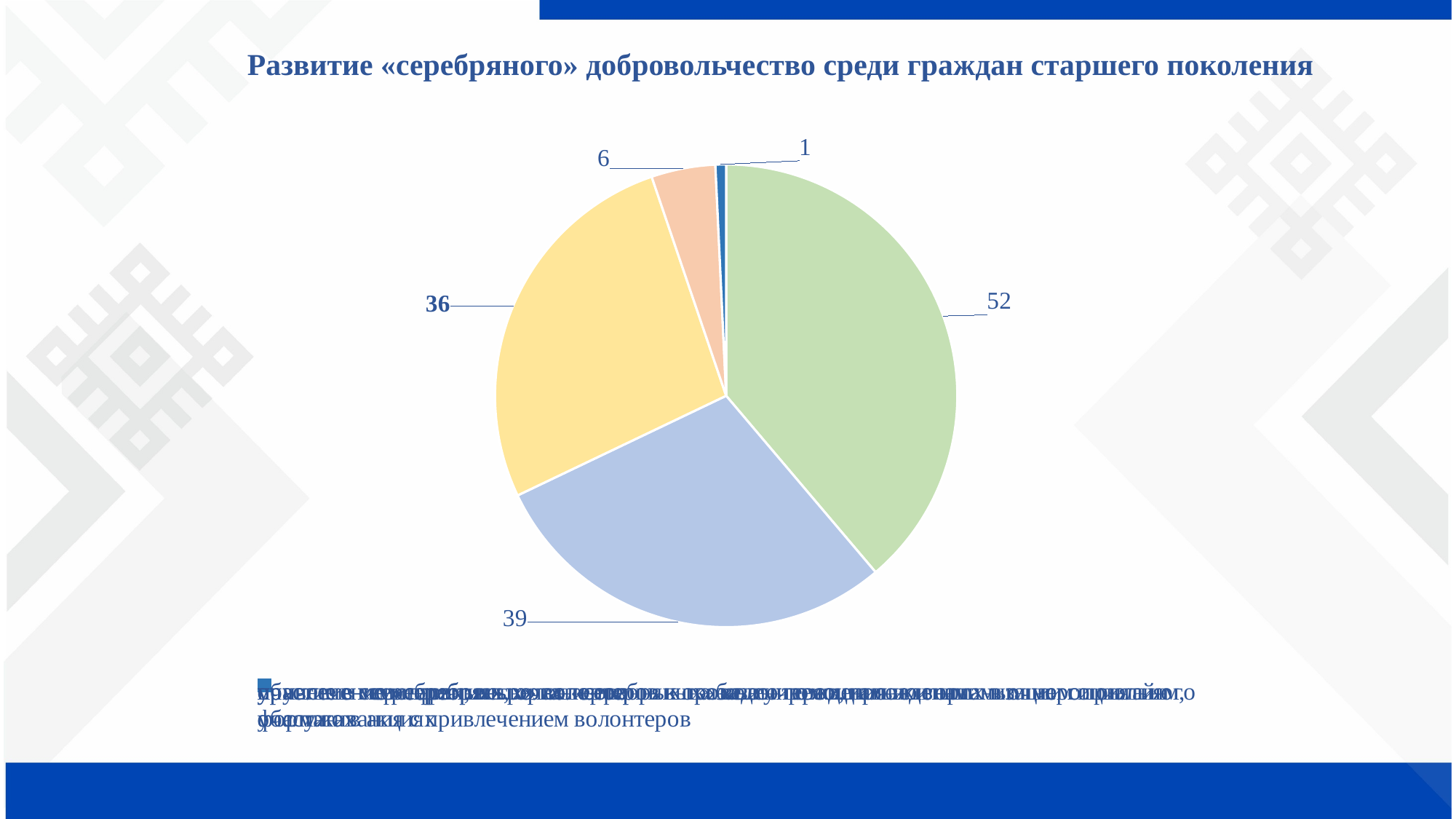
What is the sum of all the values labelled on the pie chart? 134 What is the value of the yellow slice of the pie chart? 36 How many slices does the pie chart have? 5 What is the largest value shown on the pie chart? 52 What kind of chart is shown on the slide? pie chart Which slice is larger, the green slice or the yellow slice? the green slice What is the value of the peach-coloured slice of the pie chart? 6 What is the value of the green slice of the pie chart? 52 What is the smallest value shown on the pie chart? 1 What is the difference between the largest slice (52) and the light blue slice (39)? 13 What is the title of the chart on the slide? Развитие «серебряного» добровольчество среди граждан старшего поколения What is the value of the light blue slice of the pie chart? 39